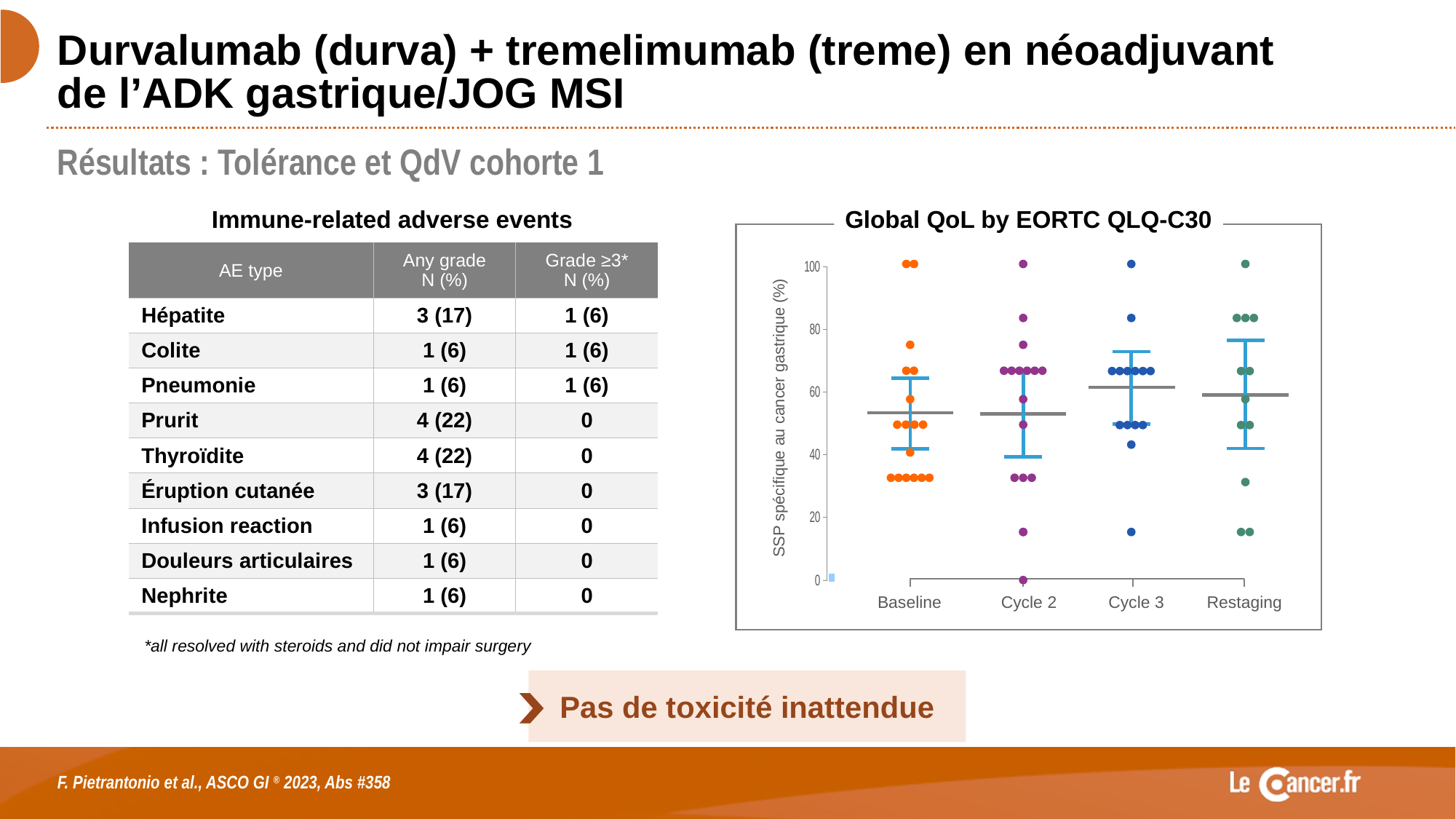
In the 'Global QoL by EORTC QLQ-C30' chart, what is the label of the last time point on the x axis? Restaging What is the title of the chart on the right of the slide? Global QoL by EORTC QLQ-C30 In the 'Global QoL by EORTC QLQ-C30' chart, which has the higher mean line, Baseline or Cycle 3? Cycle 3 In the 'Global QoL by EORTC QLQ-C30' chart, does the mean line rise or fall from Baseline to Cycle 3? rise What kind of chart is the 'Global QoL by EORTC QLQ-C30' chart? Scatter (dot) plot In the 'Global QoL by EORTC QLQ-C30' chart, is the mean line for Cycle 3 greater or less than 40? greater What is the maximum value shown on the y axis of the 'Global QoL by EORTC QLQ-C30' chart? 100 In the 'Global QoL by EORTC QLQ-C30' chart, is the lowest Cycle 2 data point greater or less than 20? less In the 'Global QoL by EORTC QLQ-C30' chart, which has the higher mean line, Cycle 2 or Restaging? Restaging In the 'Global QoL by EORTC QLQ-C30' chart, is the mean line for Cycle 2 greater or less than 60? less How many time points are shown on the x axis of the 'Global QoL by EORTC QLQ-C30' chart? 4